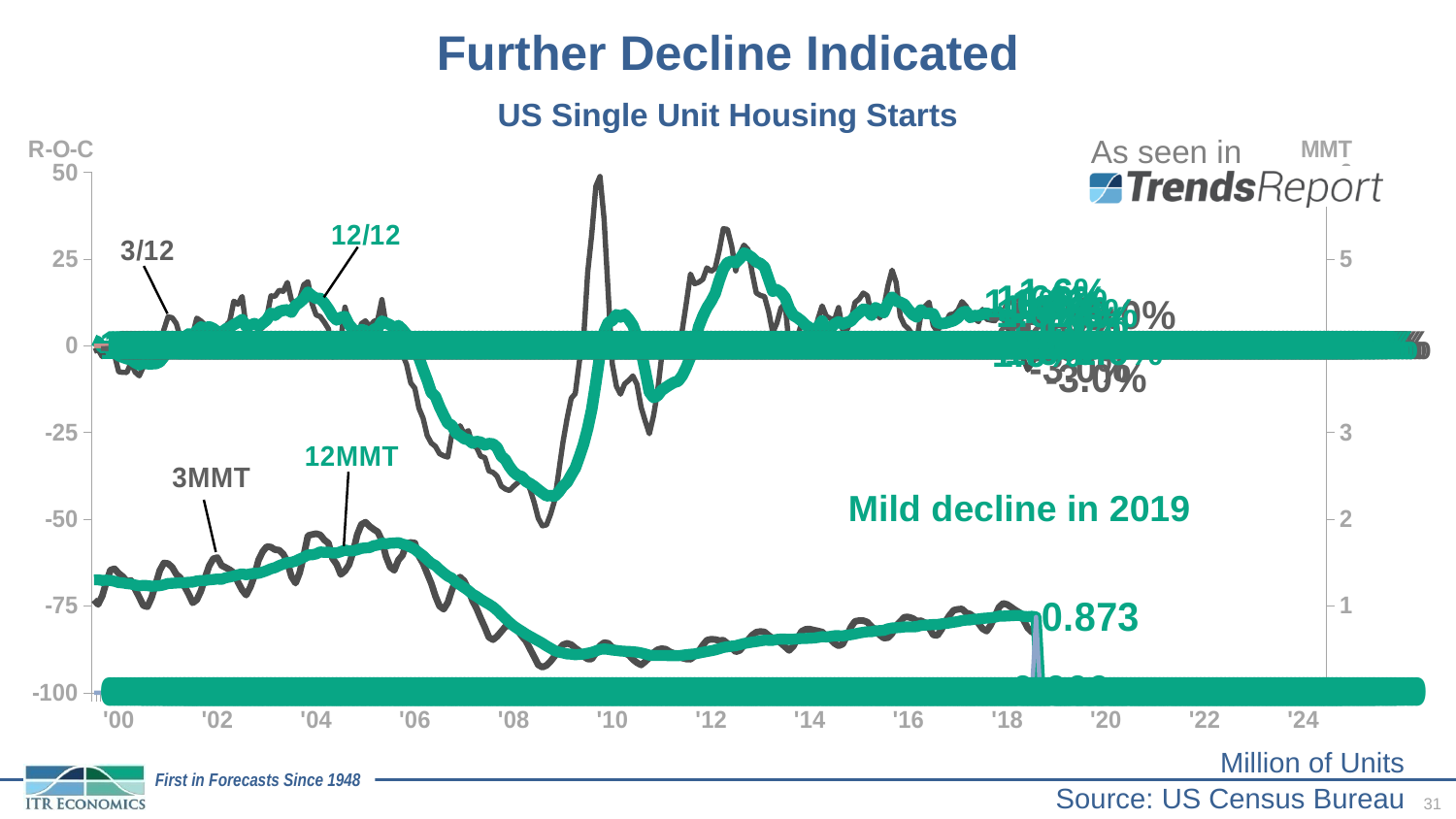
Does the 12MMT line rise or fall between '12 and '18? rise What is the latest printed value for the 12MMT series? 0.873 How many data series are labeled on the chart? 4 Is the lowest point of the 12/12 line around '08-'09 greater or less than -25? less What kind of chart is shown on the slide? line chart Does the 12MMT line rise or fall between '06 and '09? fall Is the highest point of the 3/12 line around '10 greater or less than 25? greater What annotation about 2019 is printed on the chart? Mild decline in 2019 Near which x-axis year label does the 3/12 line reach its highest point? '10 What is the title of the chart? US Single Unit Housing Starts Is the 12MMT value at '18 greater or less than 1 on the right axis? less